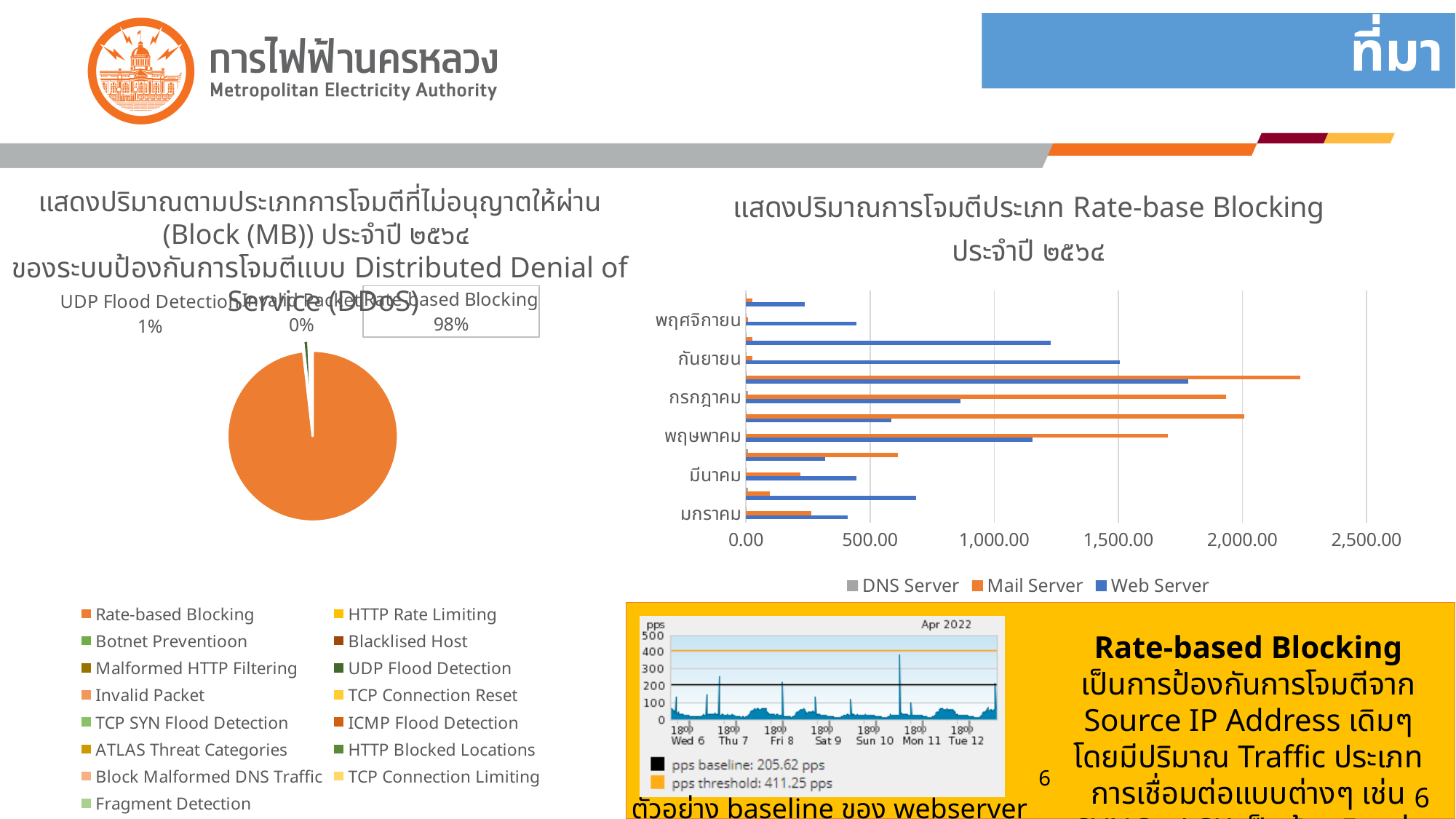
In the pie chart on the left, what share does UDP Flood Detection have? 1% How many series does the legend of the bar chart on the right list? 3 What kind of chart is the chart on the right of the slide (แสดงปริมาณการโจมตีประเภท Rate-base Blocking)? bar chart In the pie chart on the left, what share does Invalid Packet have? 0% What kind of chart is the chart on the left of the slide? pie chart In the pie chart on the left, which category has the largest slice? Rate-based Blocking In the bar chart on the right, which series is shown in orange? Mail Server In the bar chart on the right, which is larger: the Web Server value for กันยายน or the Web Server value for มกราคม? กันยายน In the bar chart on the right, is the Web Server value for มกราคม greater or less than 500.00? less In the bar chart on the right, is the Mail Server value for พฤษภาคม greater or less than 1,500.00? greater In the bar chart on the right, is the Mail Server value for กรกฎาคม greater or less than 1,500.00? greater In the pie chart on the left, what share does Rate-based Blocking have? 98%